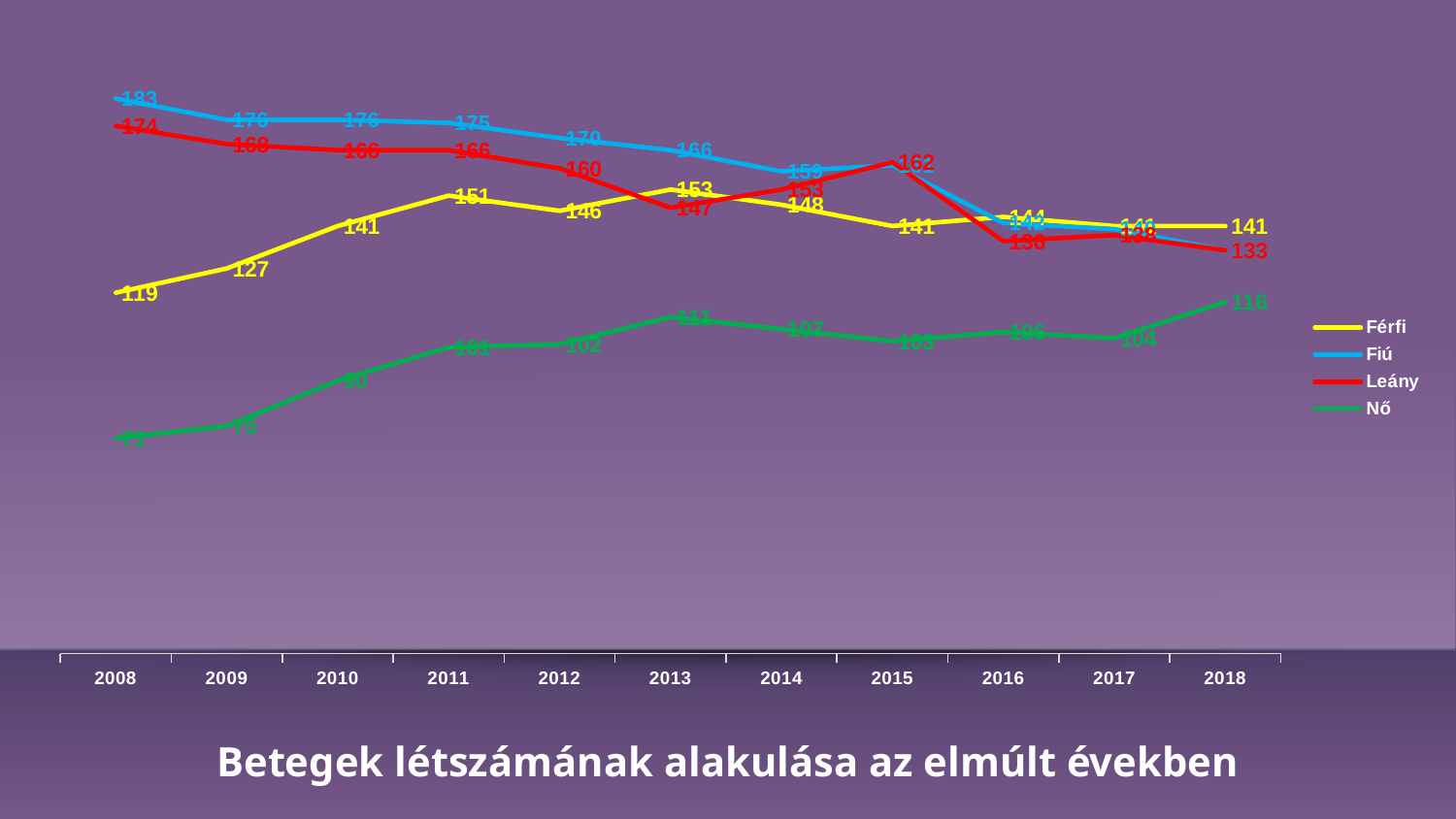
What is the value for Nő in 2018? 116 What is the difference between Fiú and Leány in 2008? 9 Does the Fiú series rise or fall from 2008 to 2018? fall In which year is the Fiú series at its highest? 2008 What type of chart is shown on the slide? line chart How many series does the legend list? 4 In which year is the Nő series at its highest? 2018 Which is larger in 2009, Férfi or Nő? Férfi How many years are shown on the x axis? 11 What is the value for Fiú in 2008? 183 What is the value for Leány in 2012? 160 What is the value for Férfi in 2011? 151